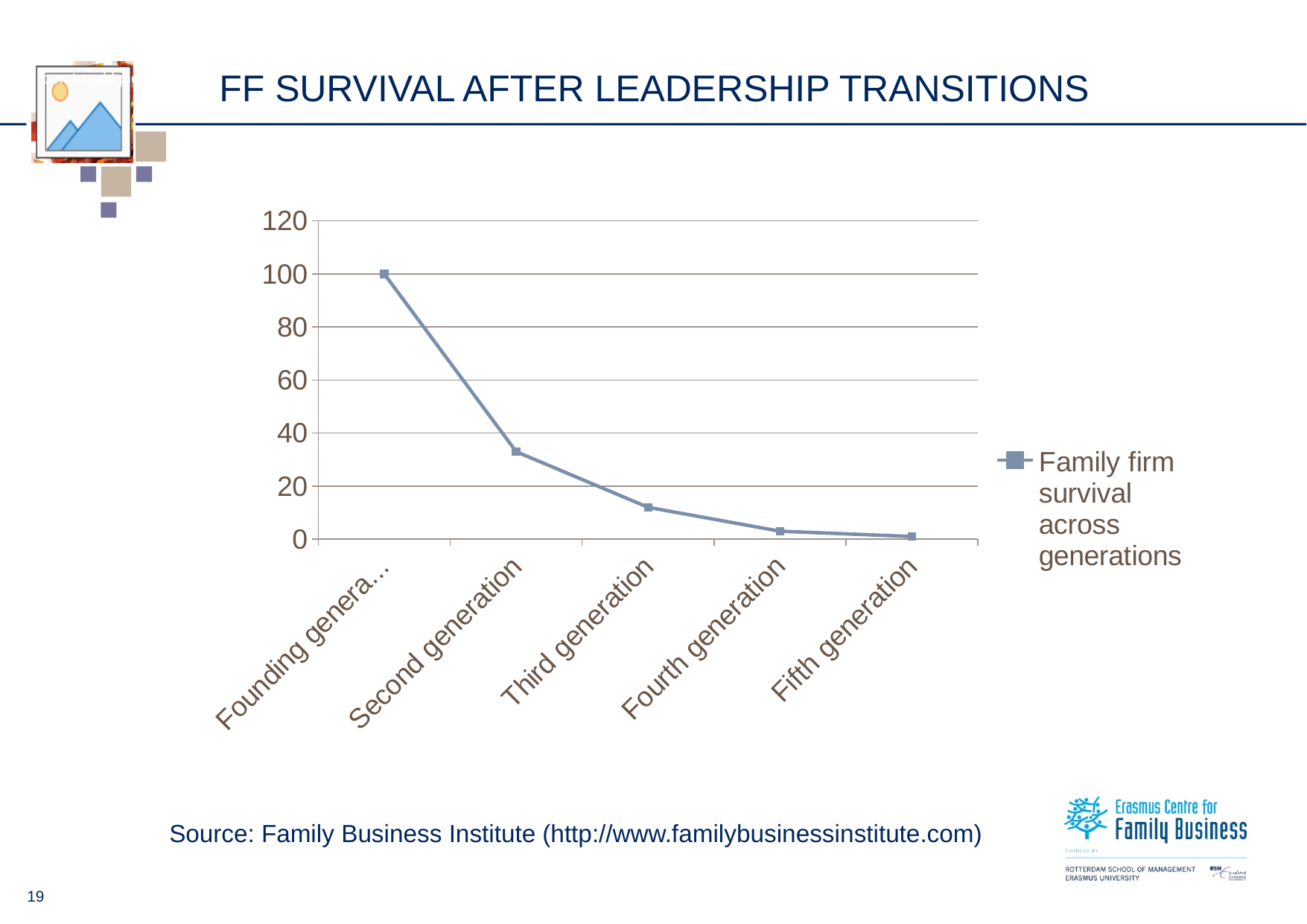
Which generation has the highest value? Founding generation Is the value for the Second generation greater or less than 20? greater What is the name of the series shown in the legend? Family firm survival across generations What is the value for the Founding generation? 100 Is the value for the Fourth generation greater or less than 20? less Is the value for the Second generation greater or less than 40? less Which is larger, the value for the Second generation or the Third generation? Second generation Do the values rise or fall from the Founding generation to the Fifth generation? fall How many series does the legend list? 1 What kind of chart is shown on the slide? line chart How many generations are plotted along the x axis? 5